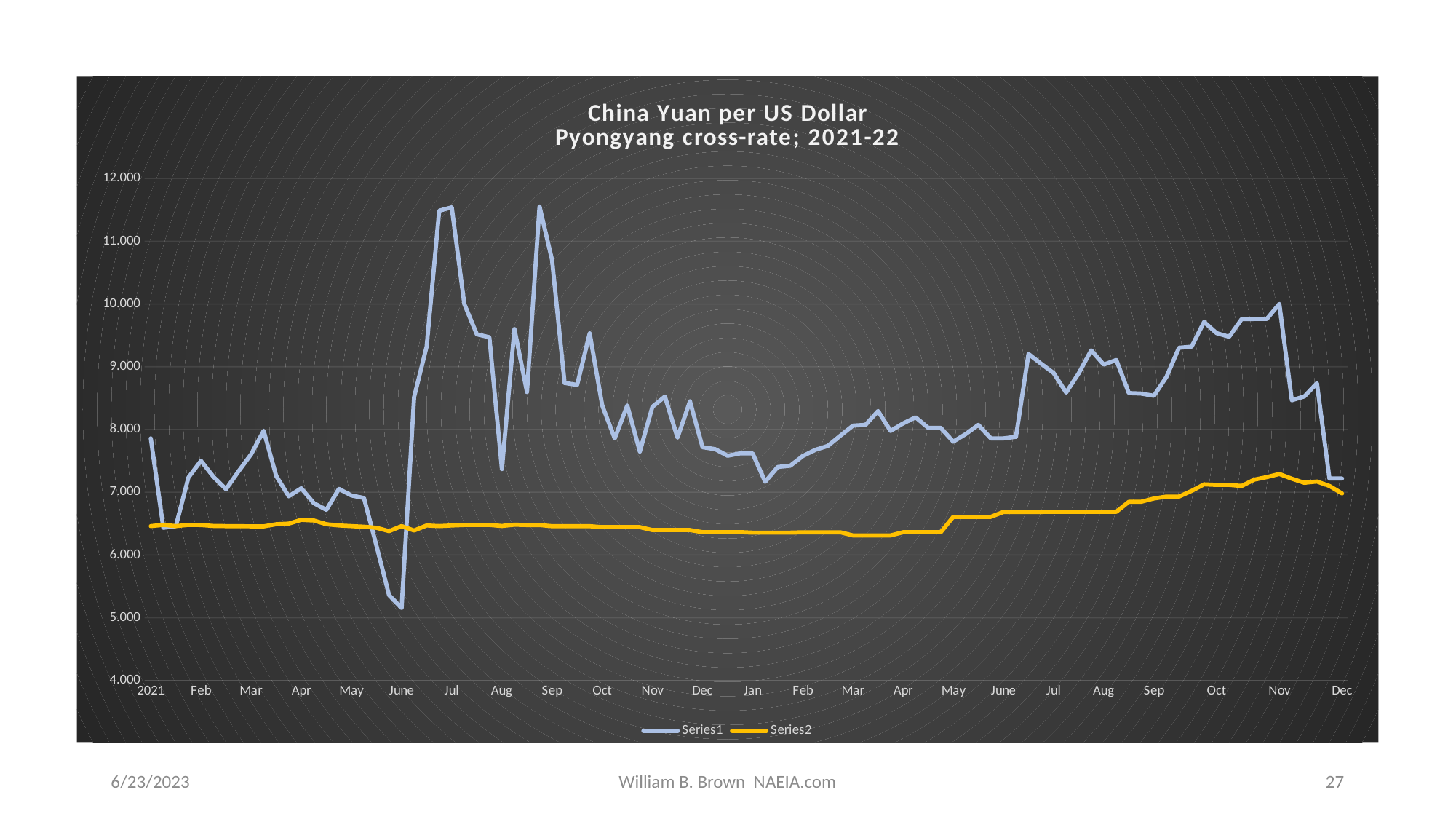
Is the value of Series2 in Jan 2022 greater or less than 7.000? less Around which month does Series2 reach its highest value? Nov 2022 Does Series2 rise or fall between May 2022 and Nov 2022? rise Around which month does Series1 reach its lowest value? June 2021 Is the peak value of Series1 around Jul 2021 greater or less than 11.000? greater What are the two series names shown in the legend? Series1 and Series2 How many series does the legend list? 2 What kind of chart is shown on the slide? line chart Which series has the higher value in Sep 2021, Series1 or Series2? Series1 Is the lowest value of Series1 around June 2021 greater or less than 6.000? less What is the title of the chart? China Yuan per US Dollar Pyongyang cross-rate; 2021-22